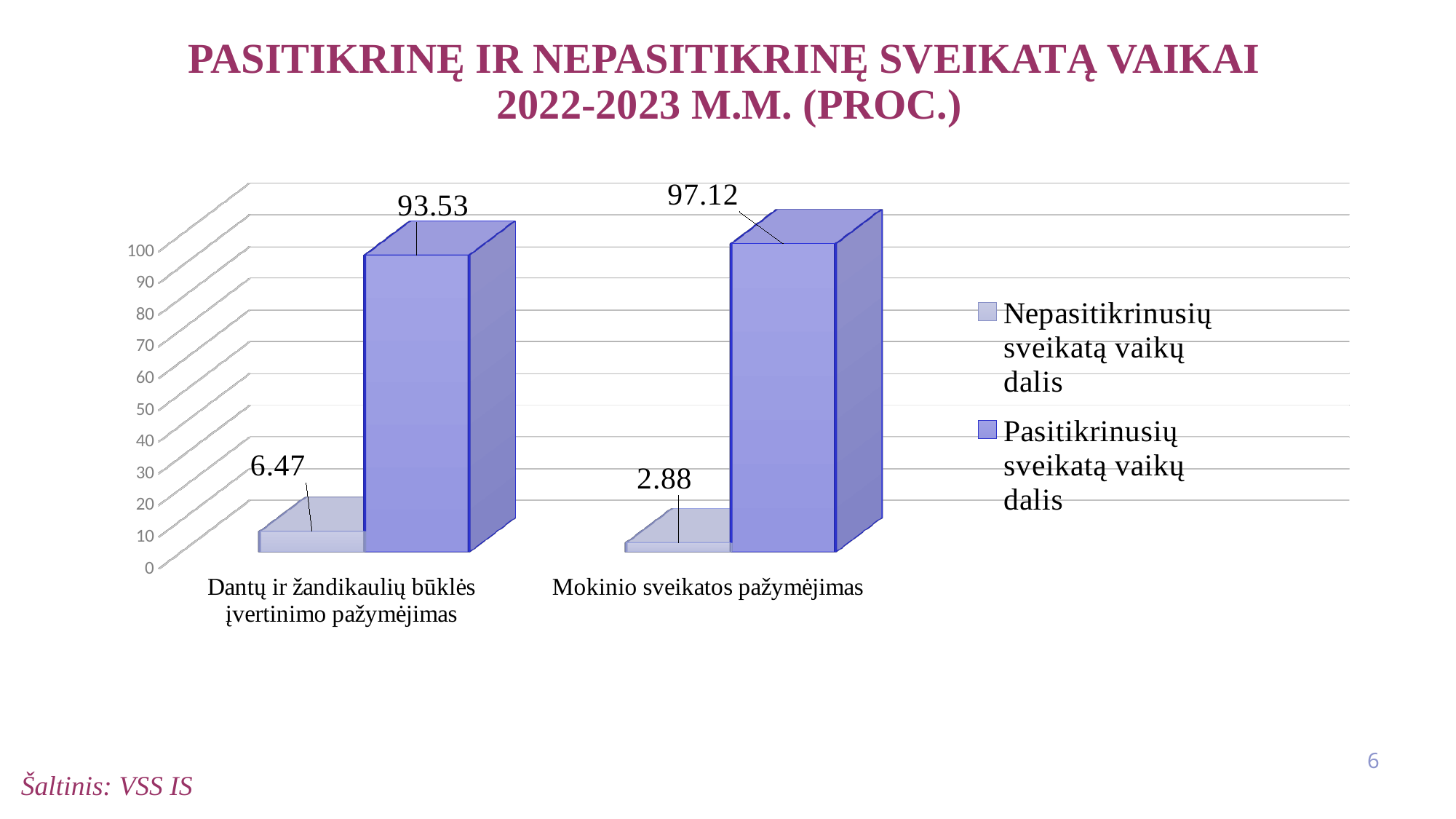
How many series does the legend list? 2 Which category has the highest value for 'Pasitikrinusių sveikatą vaikų dalis'? Mokinio sveikatos pažymėjimas What is the difference between the 'Pasitikrinusių sveikatą vaikų dalis' values for 'Mokinio sveikatos pažymėjimas' and 'Dantų ir žandikaulių būklės įvertinimo pažymėjimas'? 3.59 Which category has the lowest value for 'Nepasitikrinusių sveikatą vaikų dalis'? Mokinio sveikatos pažymėjimas How many categories are shown on the x axis of the chart? 2 What is the value for 'Pasitikrinusių sveikatą vaikų dalis' in the 'Dantų ir žandikaulių būklės įvertinimo pažymėjimas' category? 93.53 What is the value for 'Nepasitikrinusių sveikatą vaikų dalis' in the 'Dantų ir žandikaulių būklės įvertinimo pažymėjimas' category? 6.47 What is the value for 'Pasitikrinusių sveikatą vaikų dalis' in the 'Mokinio sveikatos pažymėjimas' category? 97.12 What kind of chart is shown on the slide? bar chart Is the value for 'Pasitikrinusių sveikatą vaikų dalis' in 'Dantų ir žandikaulių būklės įvertinimo pažymėjimas' greater or less than 90? greater Which is larger: the 'Nepasitikrinusių sveikatą vaikų dalis' value for 'Dantų ir žandikaulių būklės įvertinimo pažymėjimas' or for 'Mokinio sveikatos pažymėjimas'? Dantų ir žandikaulių būklės įvertinimo pažymėjimas What is the value for 'Nepasitikrinusių sveikatą vaikų dalis' in the 'Mokinio sveikatos pažymėjimas' category? 2.88